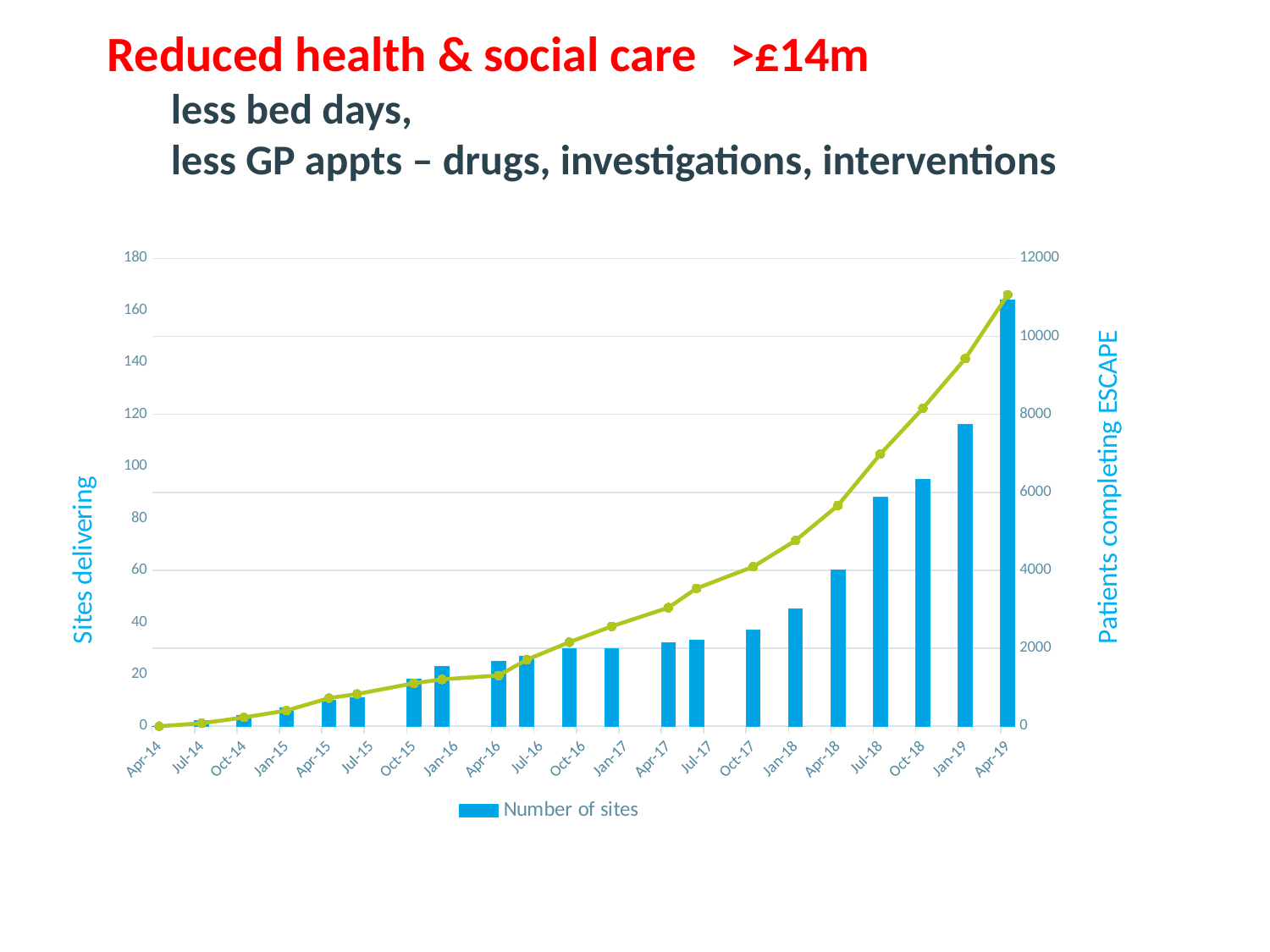
Do the Number of sites bars rise or fall from Apr-14 to Apr-19? Rise Which has the larger Number of sites bar, Jan-18 or Apr-18? Apr-18 Is the Patients completing ESCAPE line value for Apr-19 greater or less than 10000? greater Is the Number of sites bar for Jan-19 greater or less than 100? greater Is the Number of sites bar for Apr-19 greater or less than 140? greater Which period has the tallest bar for Number of sites? Apr-19 Which period has the lowest bar for Number of sites? Apr-14 What kind of chart is shown on the slide? A bar chart combined with a line What is the title of the right-hand vertical axis? Patients completing ESCAPE How many time periods are shown on the x axis? 21 How many series does the legend list? 1